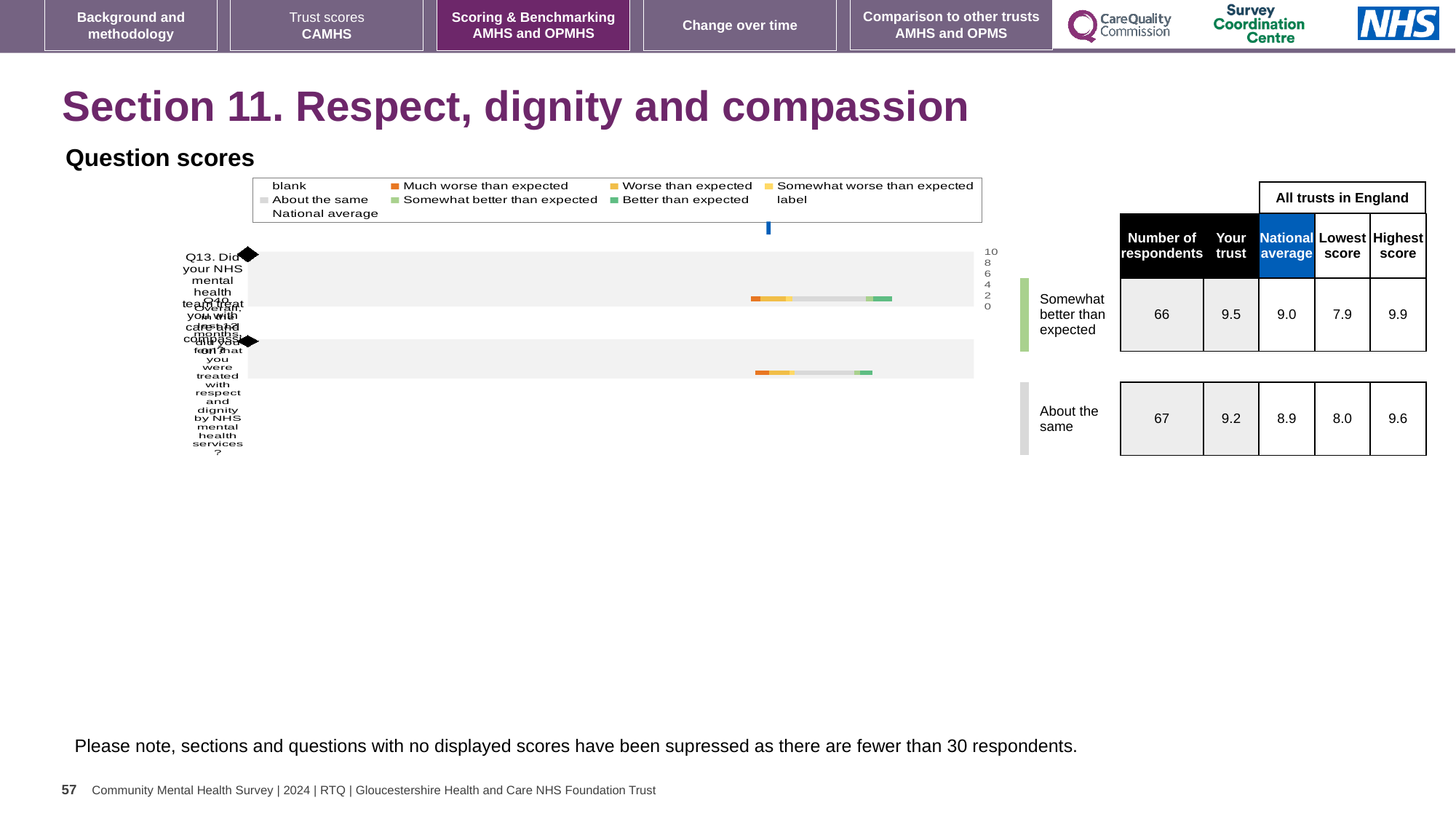
What is the lowest score shown for the row rated 'Somewhat better than expected'? 7.9 What kind of chart is shown under 'Question scores'? Bar chart In the table next to the chart, what is the 'Your trust' score for the row rated 'Somewhat better than expected'? 9.5 For the row rated 'About the same', what is the difference between the highest score and the lowest score? 1.6 How many question bars are plotted in the chart? 2 What heading appears above the 'National average', 'Lowest score' and 'Highest score' columns? All trusts in England Which row has the higher 'Your trust' score: 'Somewhat better than expected' or 'About the same'? Somewhat better than expected For the row rated 'Somewhat better than expected', how much higher is the 'Your trust' score than the national average? 0.5 How many respondents are listed for the row rated 'Somewhat better than expected'? 66 Which row has more respondents: 'Somewhat better than expected' or 'About the same'? About the same In the table next to the chart, what is the national average for the row rated 'About the same'? 8.9 What is the highest score shown for the row rated 'About the same'? 9.6